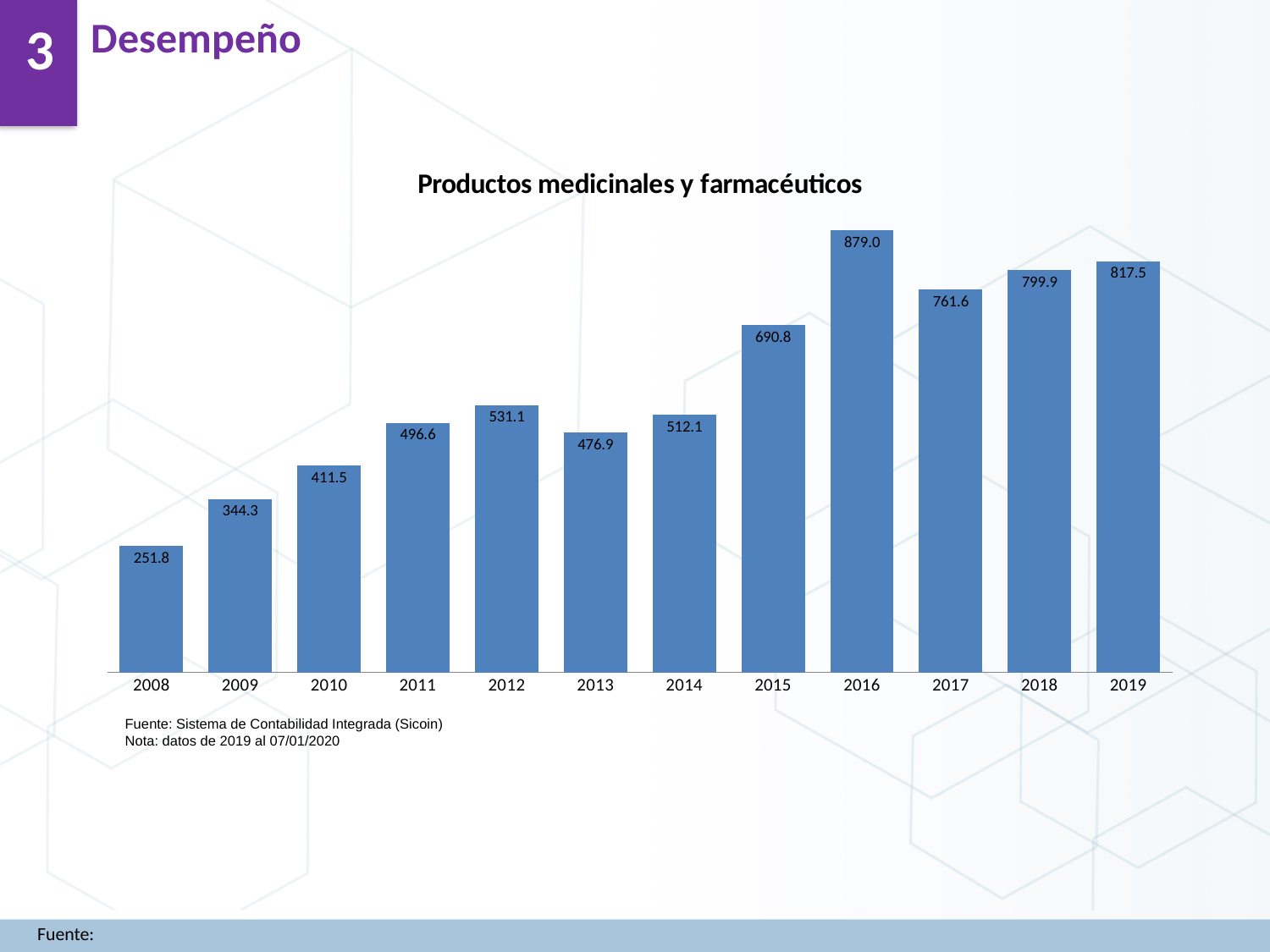
What is the value for 2016? 879.0 Which year has the highest value? 2016 What is the value for 2008? 251.8 What is the value for 2013? 476.9 What is the title of the chart? Productos medicinales y farmacéuticos What kind of chart is this? Bar chart Which is larger, the value for 2017 or the value for 2018? 2018 How many years are shown on the x axis? 12 What is the difference between the values for 2019 and 2018? 17.6 Which is larger, the value for 2012 or the value for 2013? 2012 What is the difference between the values for 2016 and 2015? 188.2 Which year has the lowest value? 2008